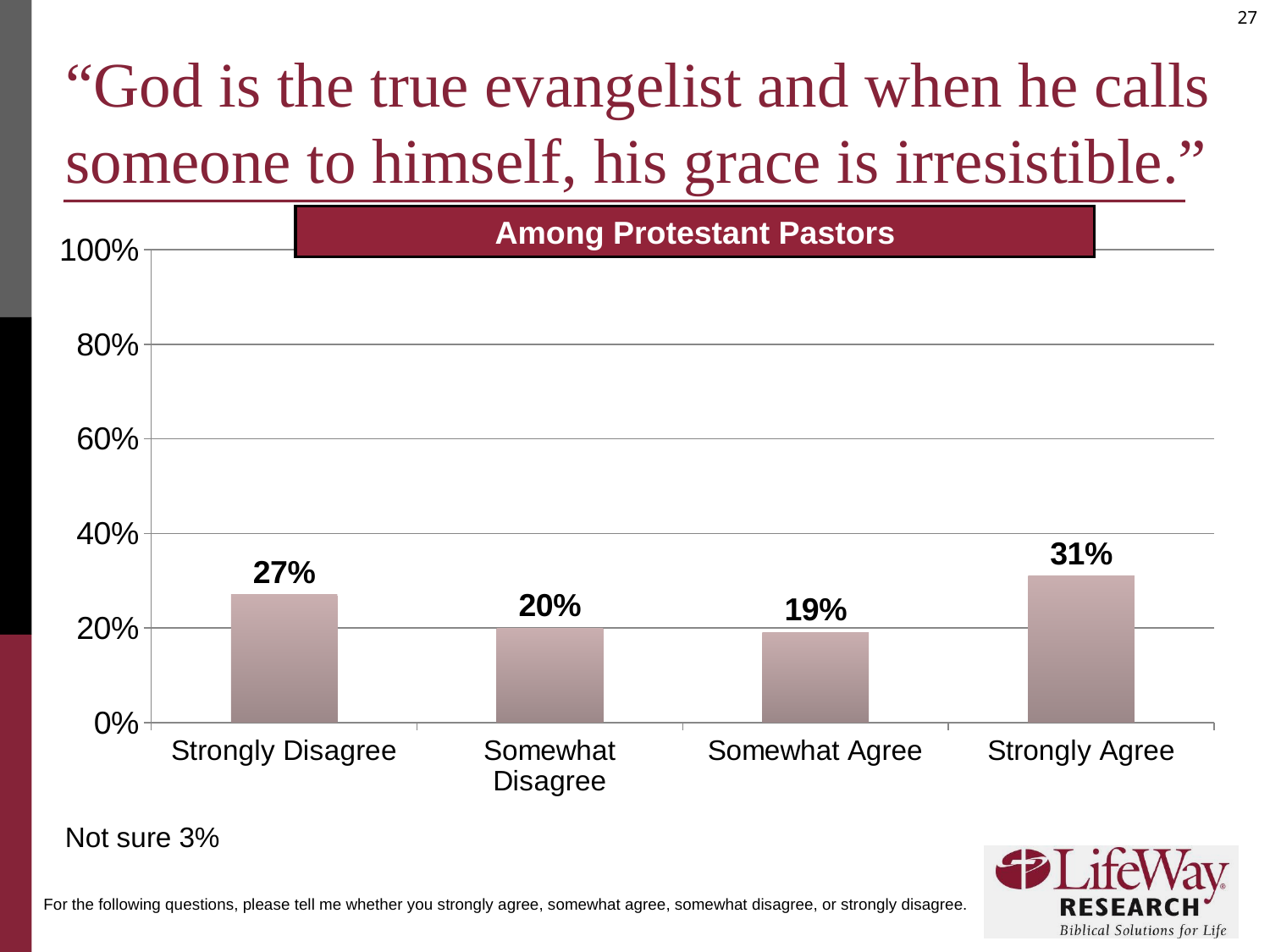
What is the difference between the Strongly Agree and Strongly Disagree percentages? 4% What percentage of Protestant pastors somewhat agree? 19% How many response categories are shown on the x axis? 4 Is the value for Strongly Agree greater or less than 40%? less Which response category has the highest percentage? Strongly Agree What percentage of Protestant pastors somewhat disagree? 20% What percentage of Protestant pastors strongly agree? 31% Which is larger, the percentage for Strongly Disagree or for Somewhat Disagree? Strongly Disagree What group does the chart's label say the results are among? Protestant Pastors What kind of chart is shown on the slide? bar chart Which response category has the lowest percentage? Somewhat Agree What percentage of Protestant pastors strongly disagree? 27%